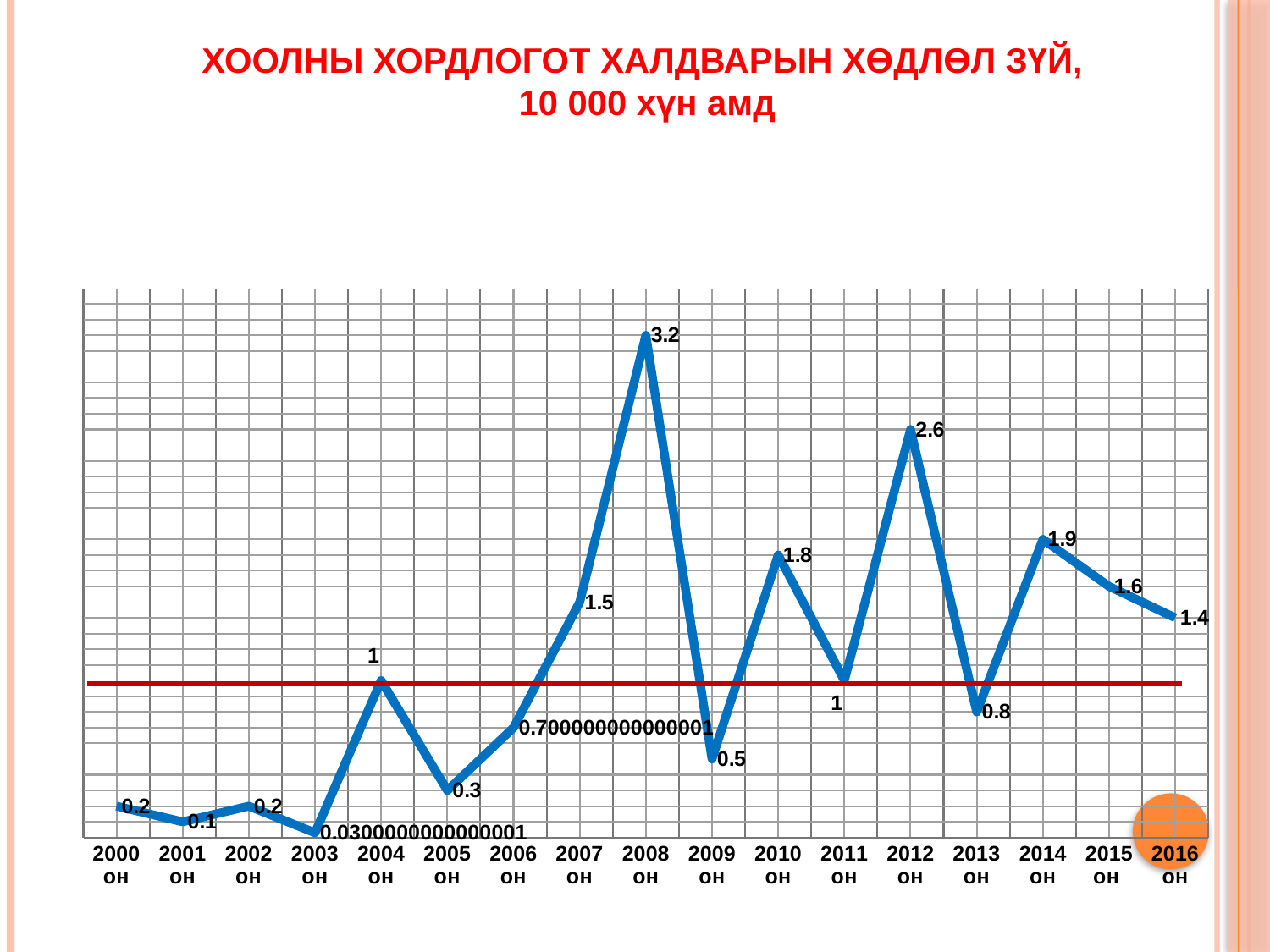
What is the value for 2005 он? 0.3 What is the value for 2012 он? 2.6 What is the difference between the values for 2008 он and 2012 он? 0.6 What kind of chart is shown on the slide? line chart How many years are plotted on the x axis? 17 Which year has the highest value? 2008 он Which is larger, the value for 2010 он or the value for 2012 он? 2012 он Do the values rise or fall from 2014 он to 2016 он? fall What is the difference between the values for 2014 он and 2013 он? 1.1 What is the value for 2008 он? 3.2 Which year has the lowest value? 2003 он What is the value for 2016 он? 1.4